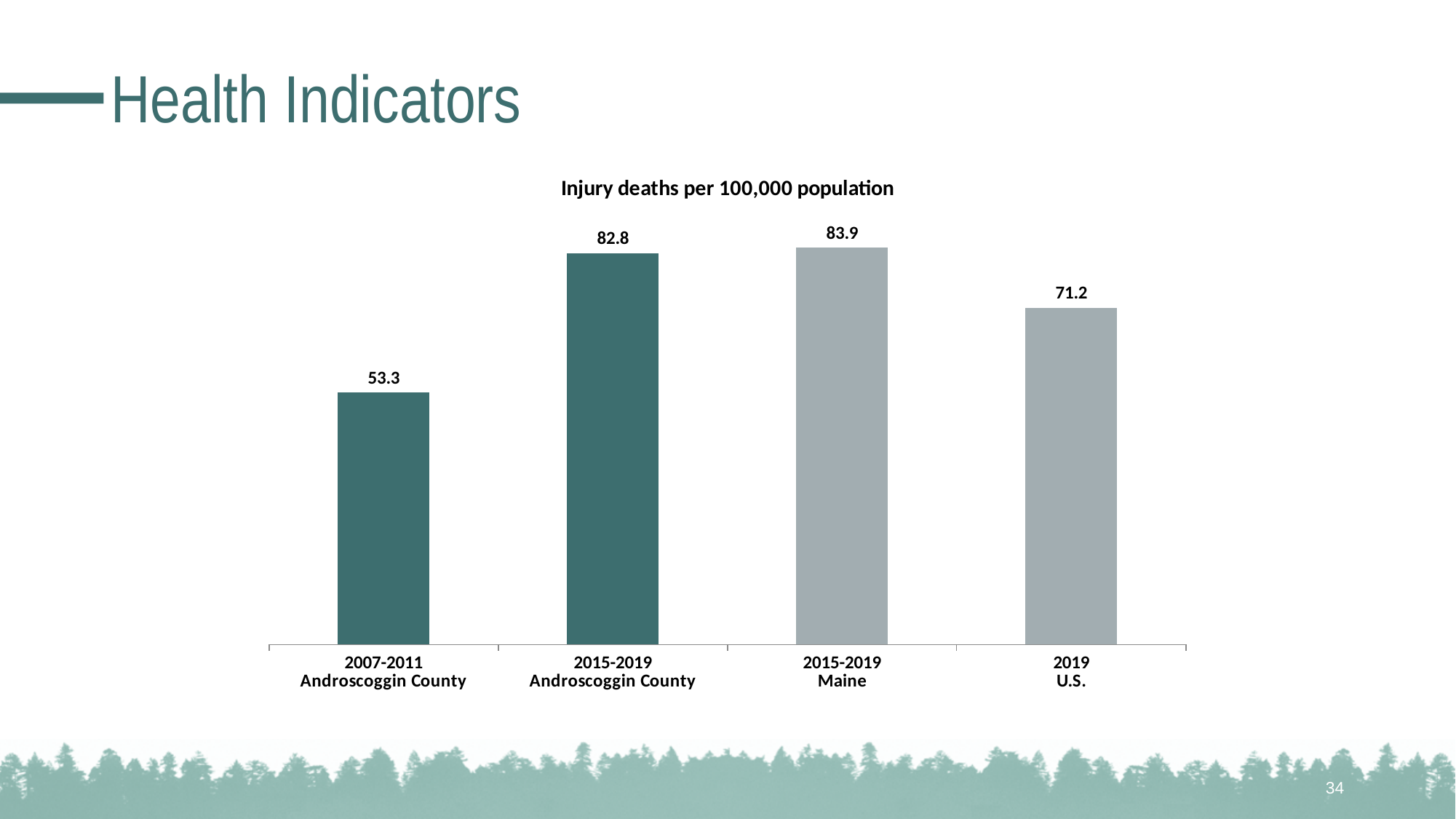
What is the value for 2015-2019 Androscoggin County? 82.8 What is the value for 2019 U.S.? 71.2 What is the difference between the 2015-2019 Androscoggin County value and the 2007-2011 Androscoggin County value? 29.5 Which category has the highest value? 2015-2019 Maine Which is larger, the value for 2019 U.S. or the value for 2007-2011 Androscoggin County? 2019 U.S. Which category has the lowest value? 2007-2011 Androscoggin County How many categories are shown in the chart? 4 What is the title of the chart? Injury deaths per 100,000 population What is the value for 2015-2019 Maine? 83.9 What kind of chart is shown on the slide? Bar chart What is the difference between the 2015-2019 Maine value and the 2019 U.S. value? 12.7 What is the value for 2007-2011 Androscoggin County? 53.3